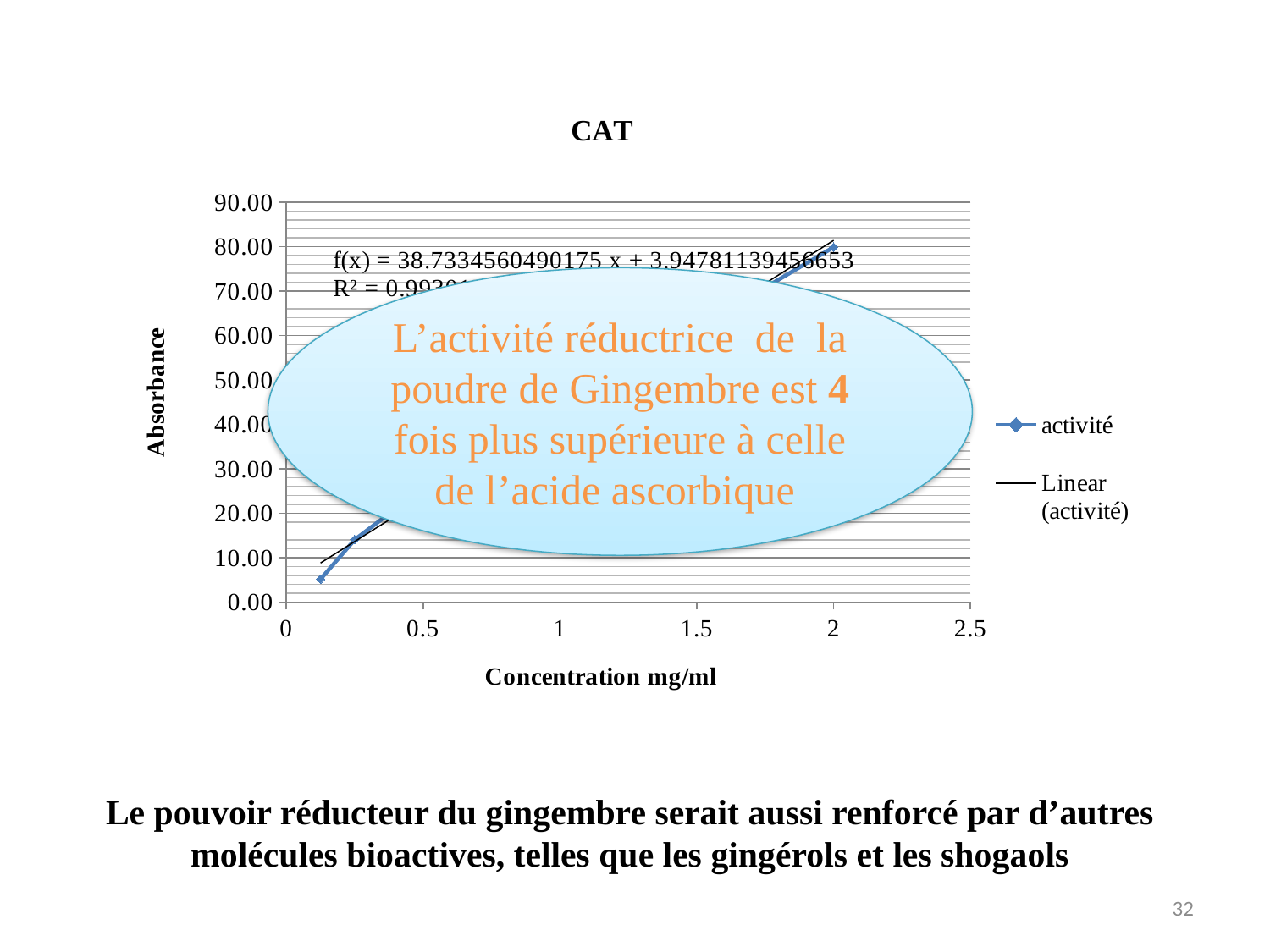
Is the absorbance value at concentration 2 greater or less than 70.00? greater What is the intercept of the linear trendline equation shown on the chart? 3.94781139456653 What is the label of the x axis? Concentration mg/ml What is the highest value shown on the y axis? 90.00 Does the absorbance rise or fall as concentration increases along the x axis? rise What is the title of the chart? CAT Is the absorbance value of the lowest plotted point greater or less than 10.00? less What kind of chart is shown on the slide? line chart (scatter with trendline) What is the slope of the linear trendline equation shown on the chart? 38.7334560490175 How many entries does the legend list? 2